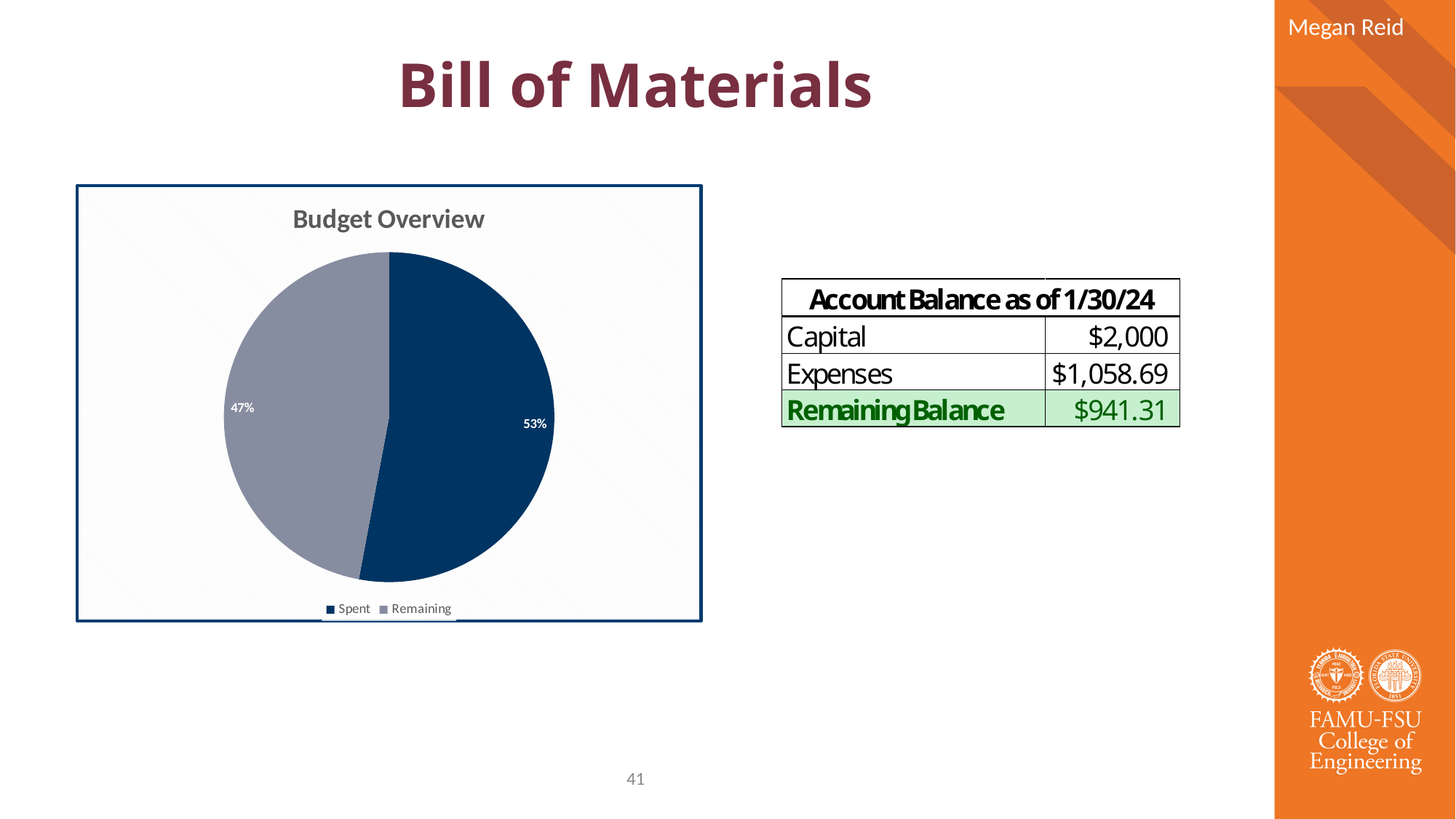
What is the title of the chart? Budget Overview Is the share for Spent greater or less than 50%? greater Which is larger, the Spent slice or the Remaining slice? Spent Which legend entry is shown in dark navy blue? Spent Which slice is the smallest in the pie chart? Remaining Which slice is the largest in the pie chart? Spent How many slices does the pie chart have? 2 What is the difference in percentage points between the Spent and Remaining slices? 6 percentage points What kind of chart is shown on the slide? pie chart How many entries does the legend list? 2 What share of the pie does the Spent slice represent? 53% What share of the pie does the Remaining slice represent? 47%